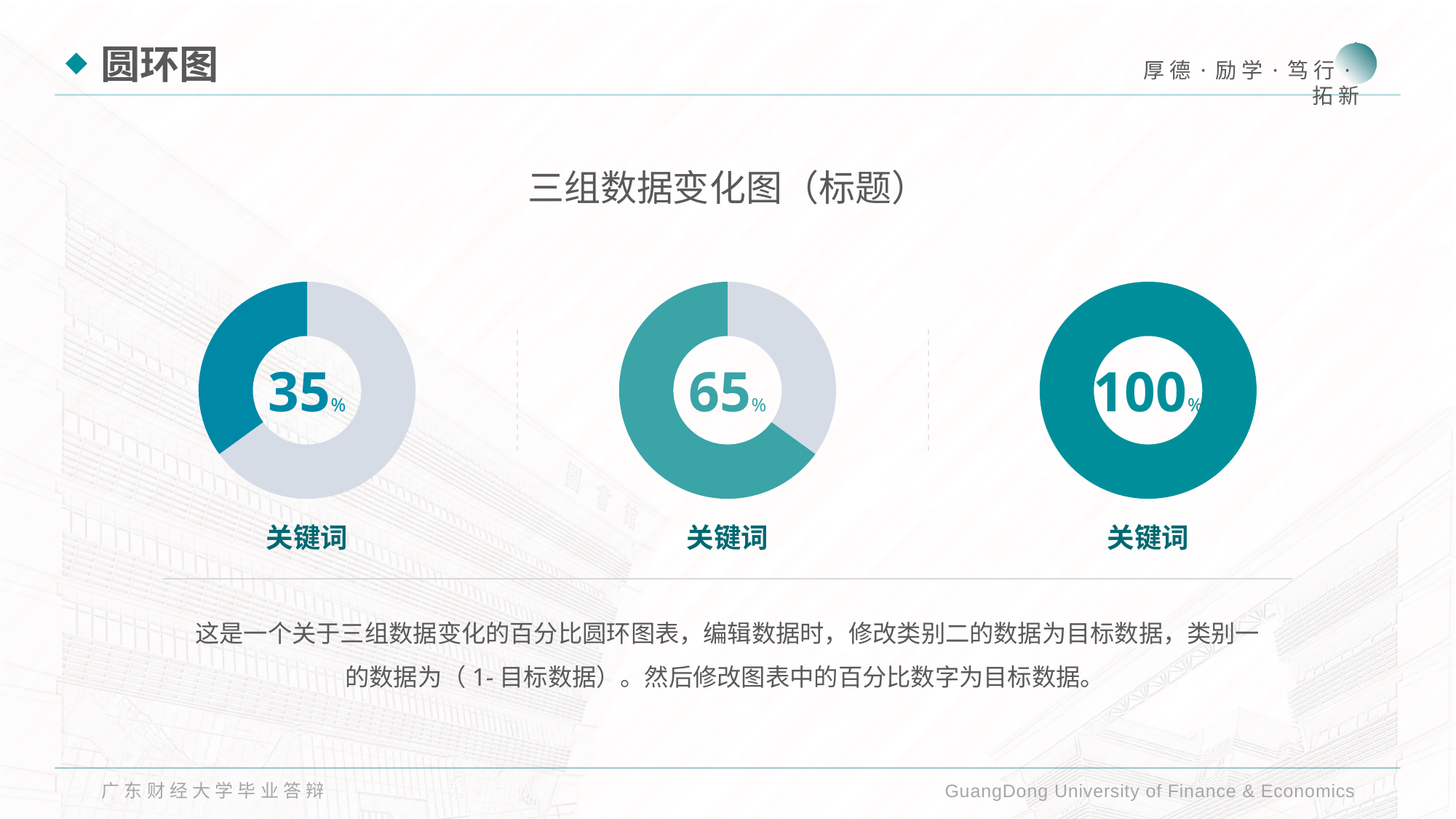
What is the difference between the percentage in the middle donut chart and the percentage in the left donut chart? 30% What value is shown in the centre of the right donut chart? 100% What value is shown in the centre of the middle donut chart? 65% What label appears beneath each of the three donut charts? 关键词 What is the difference between the percentage in the right donut chart and the percentage in the middle donut chart? 35% What is the title shown above the three donut charts? 三组数据变化图（标题） Which of the three donut charts shows the lowest percentage? The left chart (35%) What kind of chart is used on this slide? Donut chart How many donut charts are shown on the slide? 3 What value is shown in the centre of the left donut chart? 35% Which is larger, the percentage in the left donut chart or the percentage in the middle donut chart? The middle chart (65%) Which of the three donut charts shows the highest percentage? The right chart (100%)